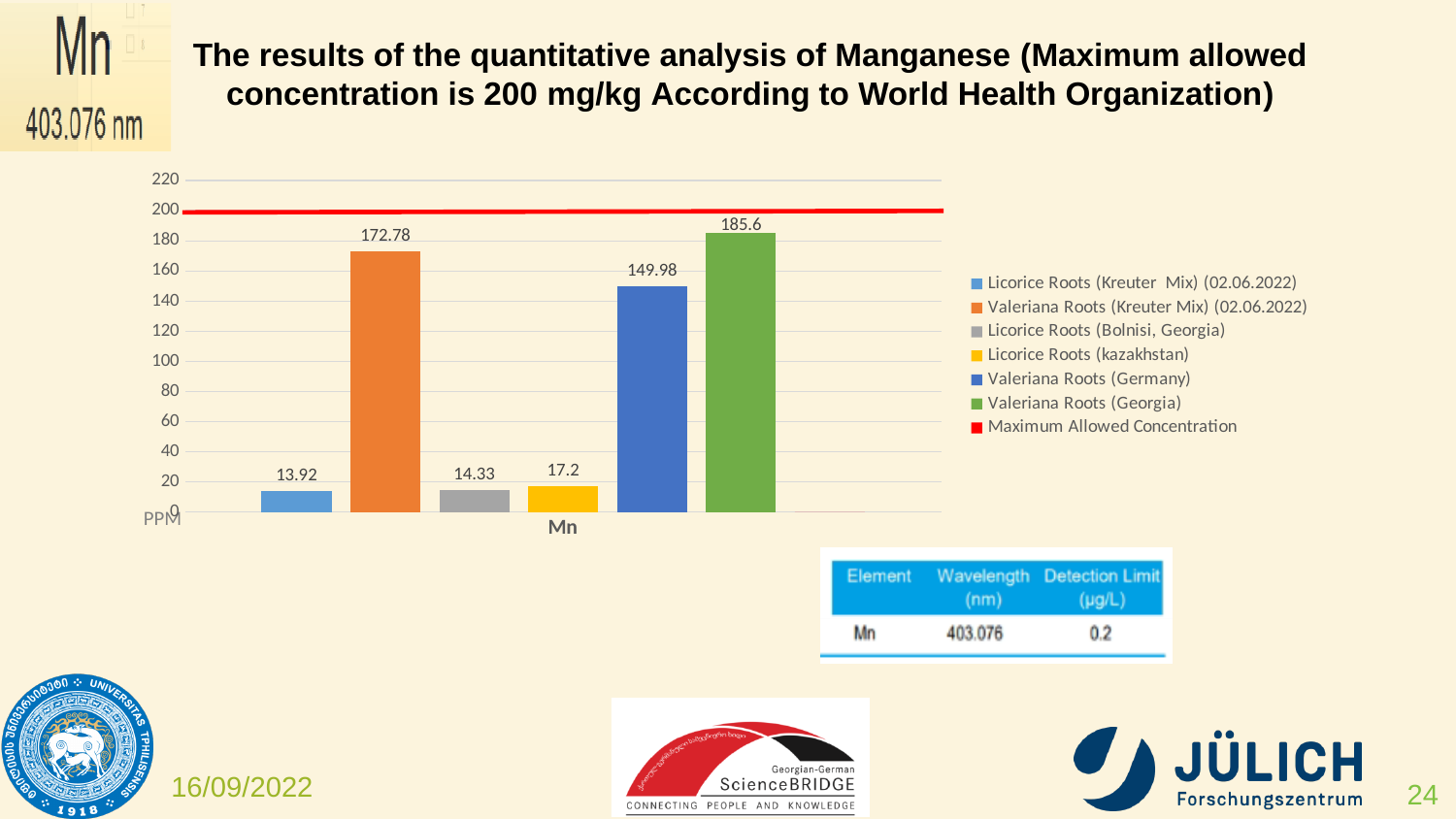
What is the value for Valeriana Roots (Germany)? 149.98 What kind of chart is shown on the slide? bar chart Which series has the highest value in the chart? Valeriana Roots (Georgia) How many entries does the legend list? 7 Which series has the lowest value in the chart? Licorice Roots (Kreuter Mix) (02.06.2022) What is the value for Licorice Roots (Kreuter Mix) (02.06.2022)? 13.92 Is the value for Valeriana Roots (Kreuter Mix) (02.06.2022) greater or less than 200? less What is the label on the x axis of the chart? Mn What is the value for Valeriana Roots (Georgia)? 185.6 At what value is the Maximum Allowed Concentration line drawn? 200 What is the difference between the values for Valeriana Roots (Georgia) and Valeriana Roots (Kreuter Mix) (02.06.2022)? 12.82 Which is larger, the value for Licorice Roots (kazakhstan) or Licorice Roots (Bolnisi, Georgia)? Licorice Roots (kazakhstan)